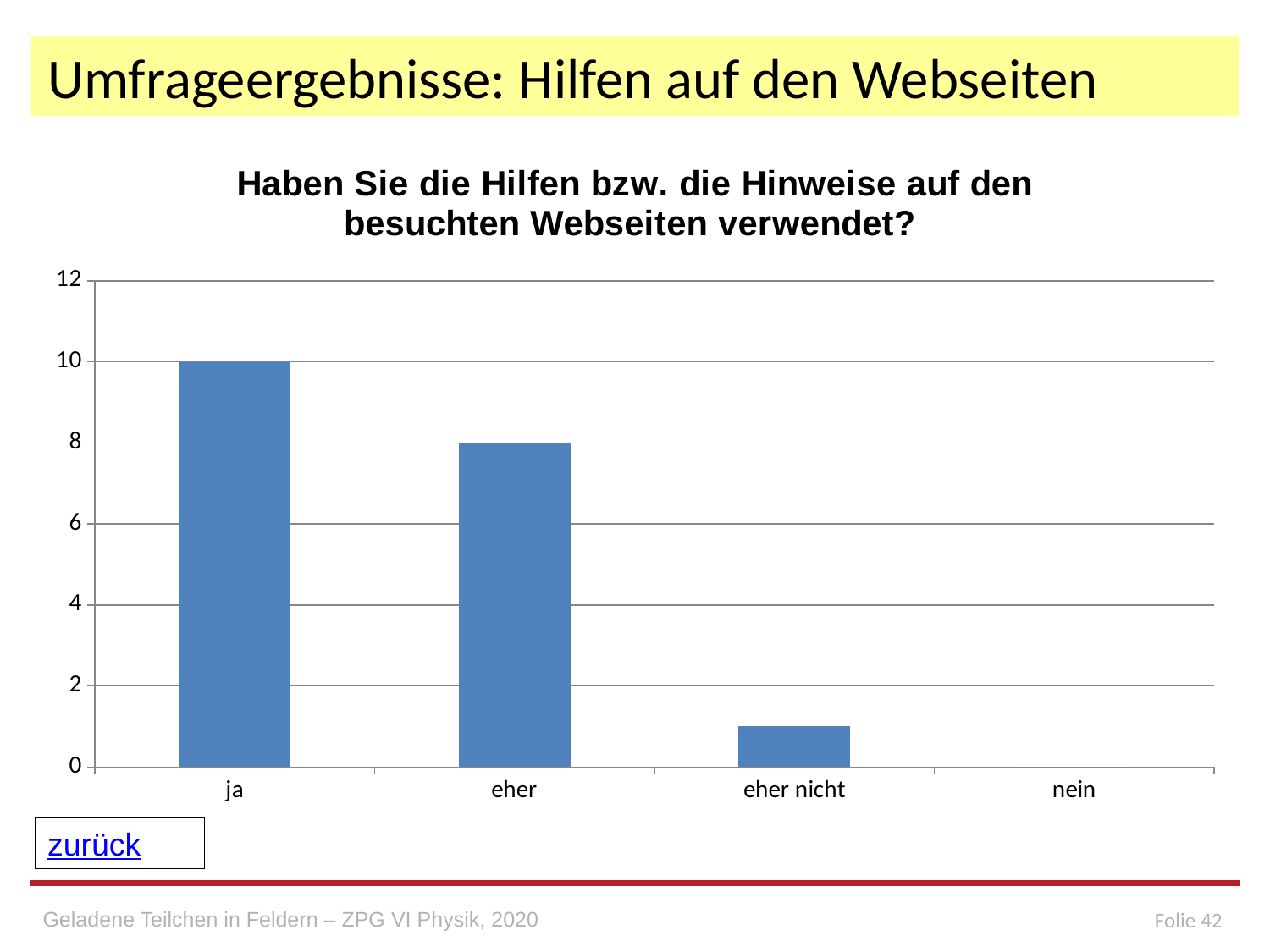
What kind of chart is shown on the slide? bar chart What is the value for "nein"? 0 What is the difference between the values for "ja" and "eher"? 2 Is the value for "eher nicht" greater or less than 2? less Do the values rise or fall from left to right along the x axis? fall Which category has the highest value? ja How many categories are shown on the x axis of the chart? 4 Which category has the lowest value? nein Which is larger, the value for "eher" or the value for "eher nicht"? eher What is the value for "eher"? 8 What is the value for "ja"? 10 What is the title of the chart? Haben Sie die Hilfen bzw. die Hinweise auf den besuchten Webseiten verwendet?